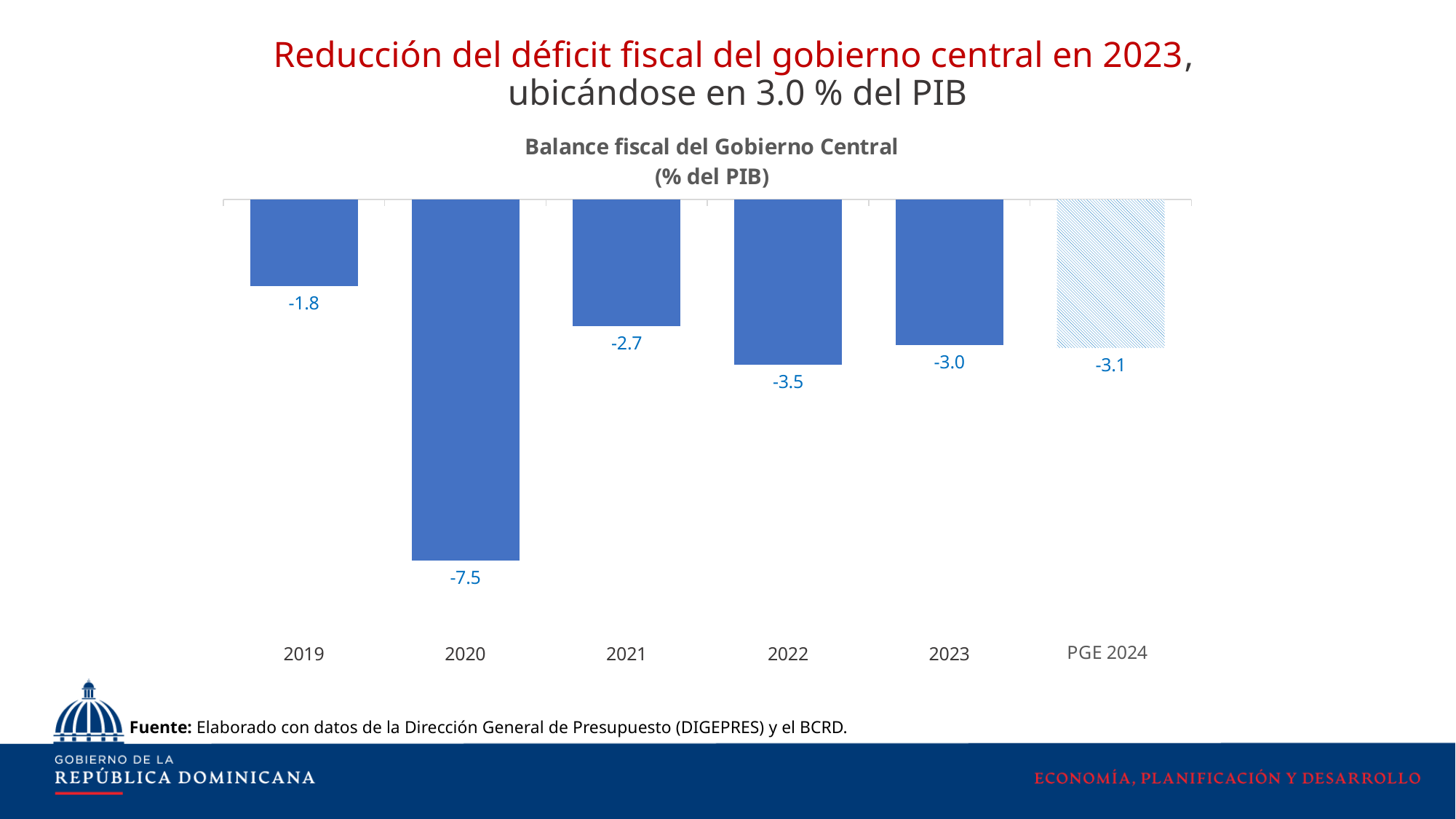
What is the value for 2019 in the Balance fiscal del Gobierno Central chart? -1.8 What is the value for 2023 in the Balance fiscal del Gobierno Central chart? -3.0 What is the value for PGE 2024 in the Balance fiscal del Gobierno Central chart? -3.1 Which year has the lowest (most negative) value in the Balance fiscal del Gobierno Central chart? 2020 Which is larger (less negative), the value for 2021 or the value for 2022 in the Balance fiscal del Gobierno Central chart? 2021 What unit is given in the subtitle of the Balance fiscal del Gobierno Central chart? % del PIB What is the difference between the values for 2022 and 2023 in the Balance fiscal del Gobierno Central chart? 0.5 What kind of chart is the Balance fiscal del Gobierno Central chart? Bar chart How many categories are shown on the x axis of the Balance fiscal del Gobierno Central chart? 6 Which category has the highest (least negative) value in the Balance fiscal del Gobierno Central chart? 2019 What is the difference between the values for 2020 and 2021 in the Balance fiscal del Gobierno Central chart? 4.8 What is the value for 2020 in the Balance fiscal del Gobierno Central chart? -7.5